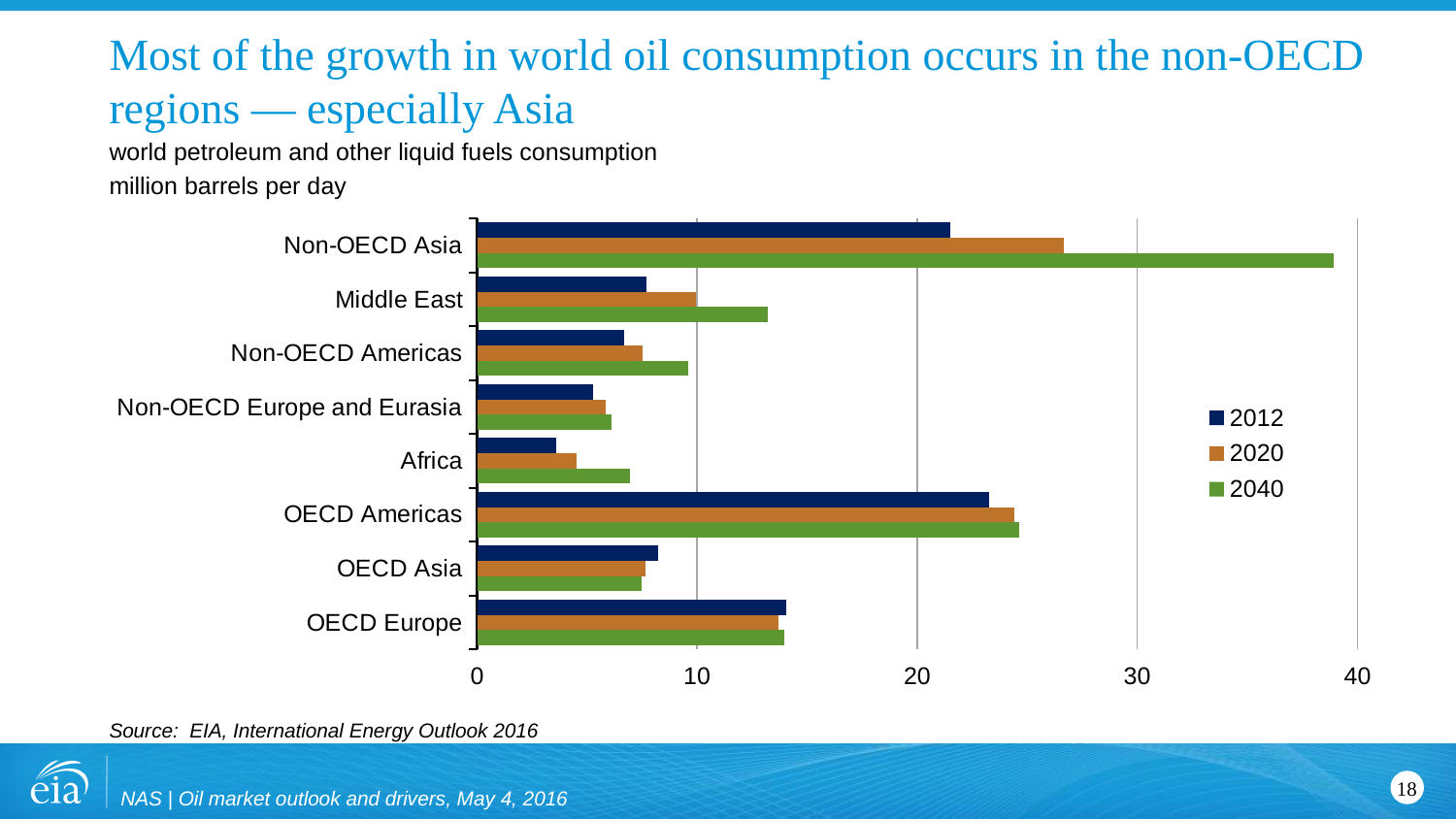
What unit is the consumption measured in, according to the chart subtitle? million barrels per day How many series does the legend list? 3 Is the 2012 value for Africa greater or less than 5? less Is the 2040 value for Middle East greater or less than 10? greater Which region has the highest consumption in 2012? OECD Americas How many regions are listed on the chart? 8 Which region has the highest consumption in 2040? Non-OECD Asia Is the 2040 value for Non-OECD Asia greater or less than 30? greater What kind of chart is shown on the slide? bar chart Which is larger in 2020: Non-OECD Asia or OECD Americas? Non-OECD Asia Which region has the lowest consumption in 2012? Africa